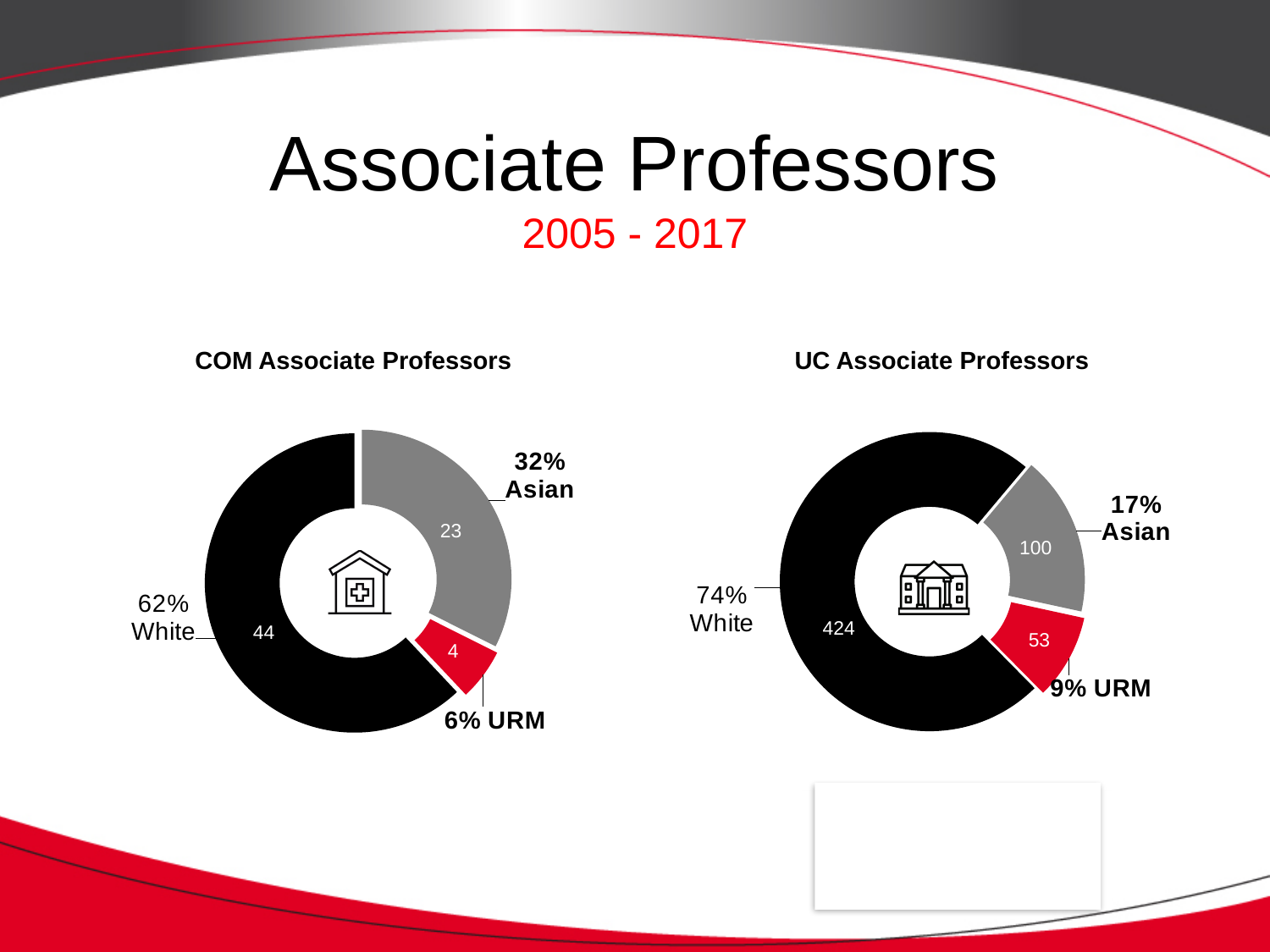
In the COM Associate Professors chart, what is the value for Asian? 23 In the UC Associate Professors chart, what is the value for White? 424 In the COM Associate Professors chart, what share of the pie is Asian? 32% In the UC Associate Professors chart, what is the difference between the White and Asian values? 324 In the COM Associate Professors chart, what is the value for URM? 4 In the UC Associate Professors chart, what is the value for Asian? 100 In the COM Associate Professors chart, what is the value for White? 44 In the UC Associate Professors chart, what share of the pie is URM? 9% In the UC Associate Professors chart, which category is the smallest? URM What kind of chart is the COM Associate Professors chart? Donut (pie) chart In the UC Associate Professors chart, what is the value for URM? 53 In the COM Associate Professors chart, which category is the largest? White